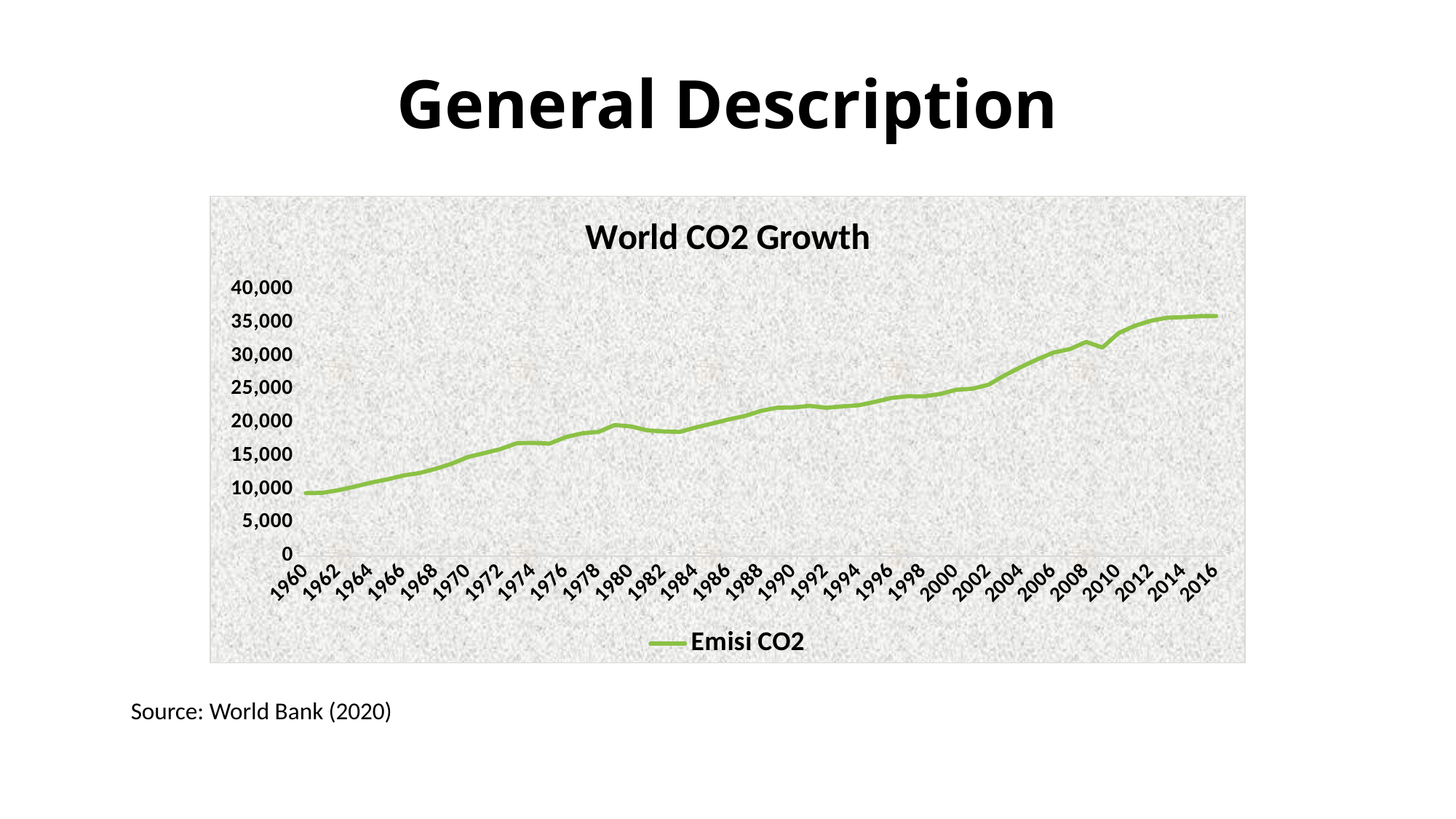
Is the value for 1990 greater or less than 20,000? greater In which year is the Emisi CO2 value highest? 2016 What kind of chart is shown on the slide? line chart Is the value for 1960 greater or less than 15,000? less Do the values of Emisi CO2 generally rise or fall from 1960 to 2016? rise Is the value for 2016 greater or less than 30,000? greater How many series does the legend list? 1 In which year is the Emisi CO2 value lowest? 1960 What is the title of the chart? World CO2 Growth Which year has the larger Emisi CO2 value, 1980 or 2008? 2008 What is the name of the series shown in the legend? Emisi CO2